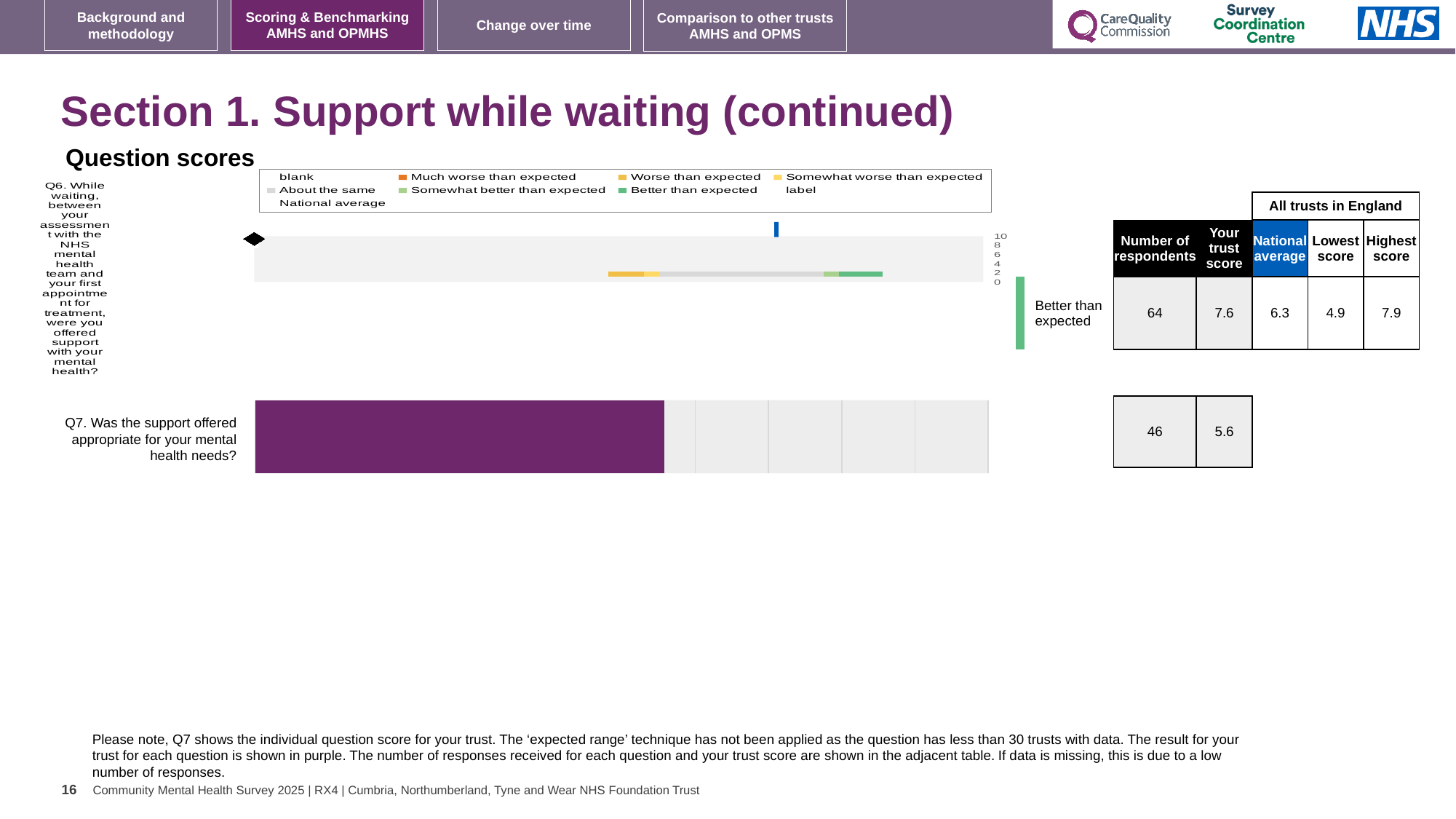
How many respondents answered Q7? 46 What is the trust score for Q6 shown in the table? 7.6 What is the national average for Q6? 6.3 What is the highest score among all trusts in England for Q6? 7.9 By how much does the trust score for Q6 exceed the national average? 1.3 What is the trust score for Q7? 5.6 What benchmark category label is shown next to the Q6 bar? Better than expected Is the value of the purple bar for Q7 greater or less than 4? greater Which question had more respondents, Q6 or Q7? Q6 What is the difference between the highest and lowest scores for Q6 across all trusts in England? 3.0 What is the lowest score among all trusts in England for Q6? 4.9 Is the trust score for Q6 higher or lower than the national average? Higher